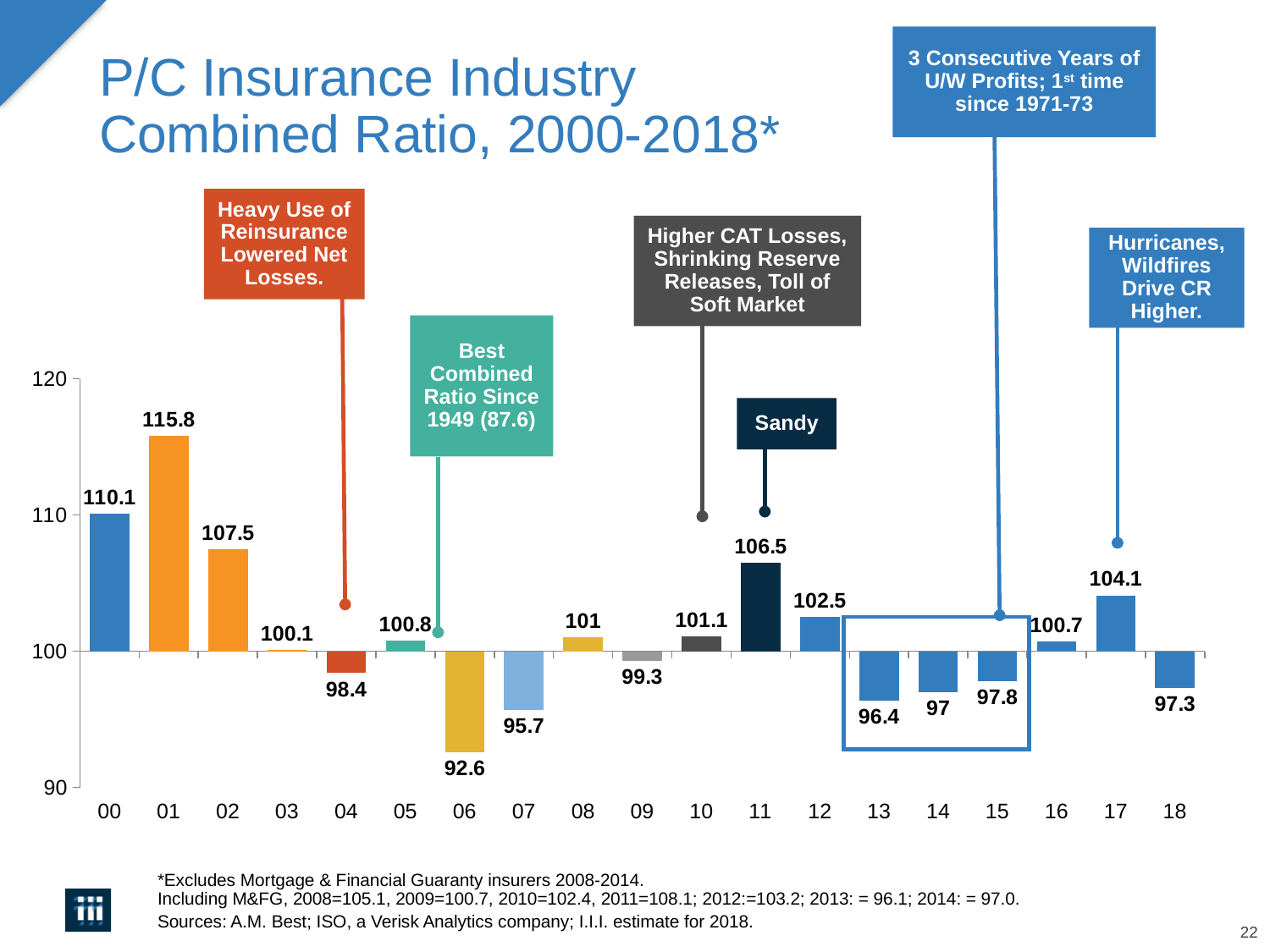
How many years are shown on the x axis? 19 What is the difference between the combined ratio in 2011 and in 2012? 4 Which year has the highest combined ratio? 01 Which year has a higher combined ratio, 2017 or 2016? 2017 What kind of chart is this? bar chart What is the combined ratio for 2006? 92.6 What is the combined ratio for 2001? 115.8 Does the combined ratio rise or fall from 2000 to 2001? rise What is the title of the chart? P/C Insurance Industry Combined Ratio, 2000-2018* Which year has the lowest combined ratio? 06 What is the combined ratio for 2018? 97.3 Is the combined ratio for 2002 greater or less than 100? greater